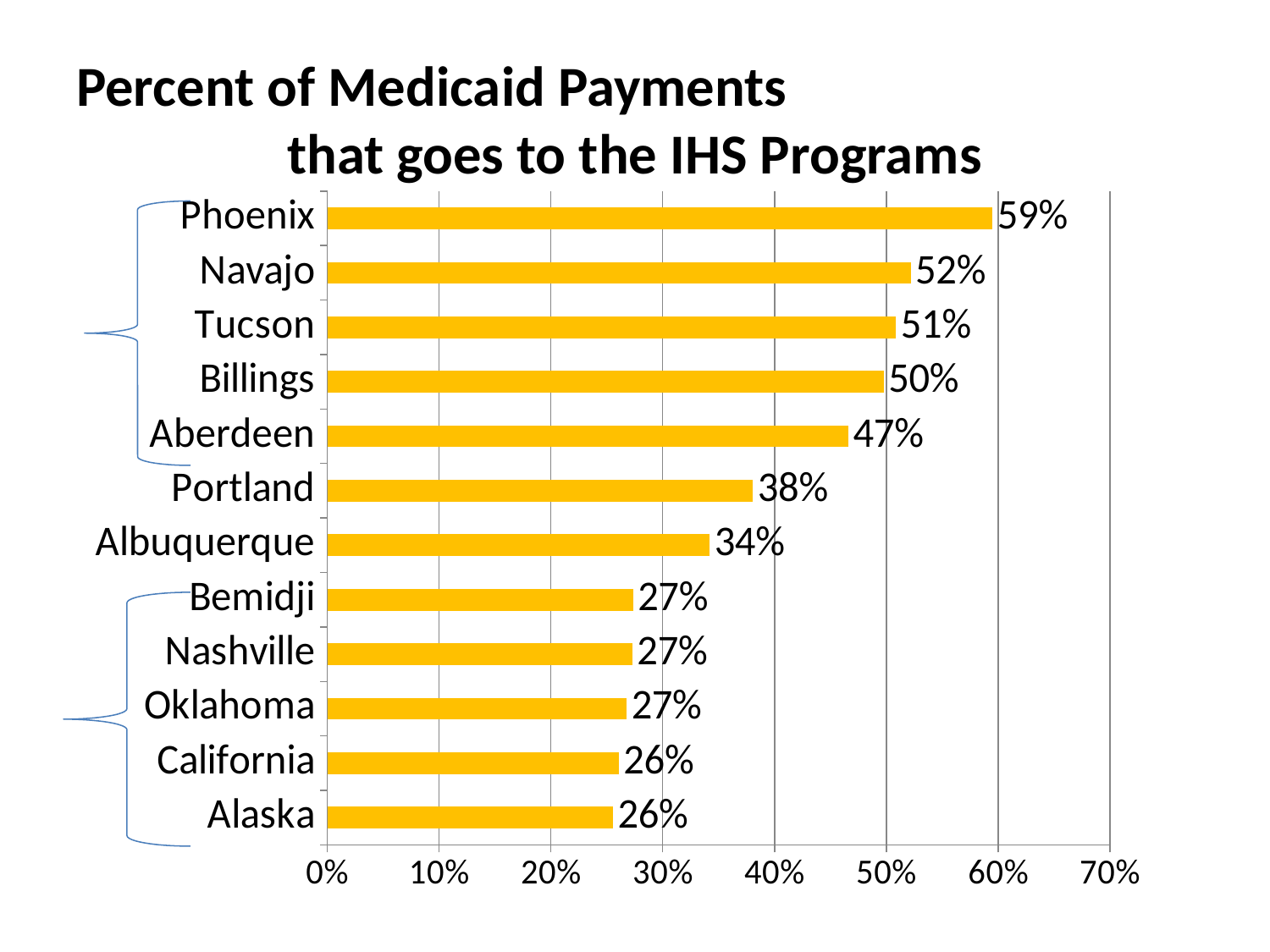
What kind of chart is shown on the slide? Bar chart Which is larger, the value for Tucson or the value for Portland? Tucson Which category has the highest value? Phoenix What is the difference between the values for Billings and Albuquerque? 16% Is the value for Navajo greater or less than 50%? greater What is the difference between the values for Phoenix and Navajo? 7% What is the value for Portland? 38% What is the value for Aberdeen? 47% Is the value for Albuquerque greater or less than 40%? less What is the value for Phoenix? 59% What is the title of the chart? Percent of Medicaid Payments that goes to the IHS Programs How many categories are shown in the chart? 12